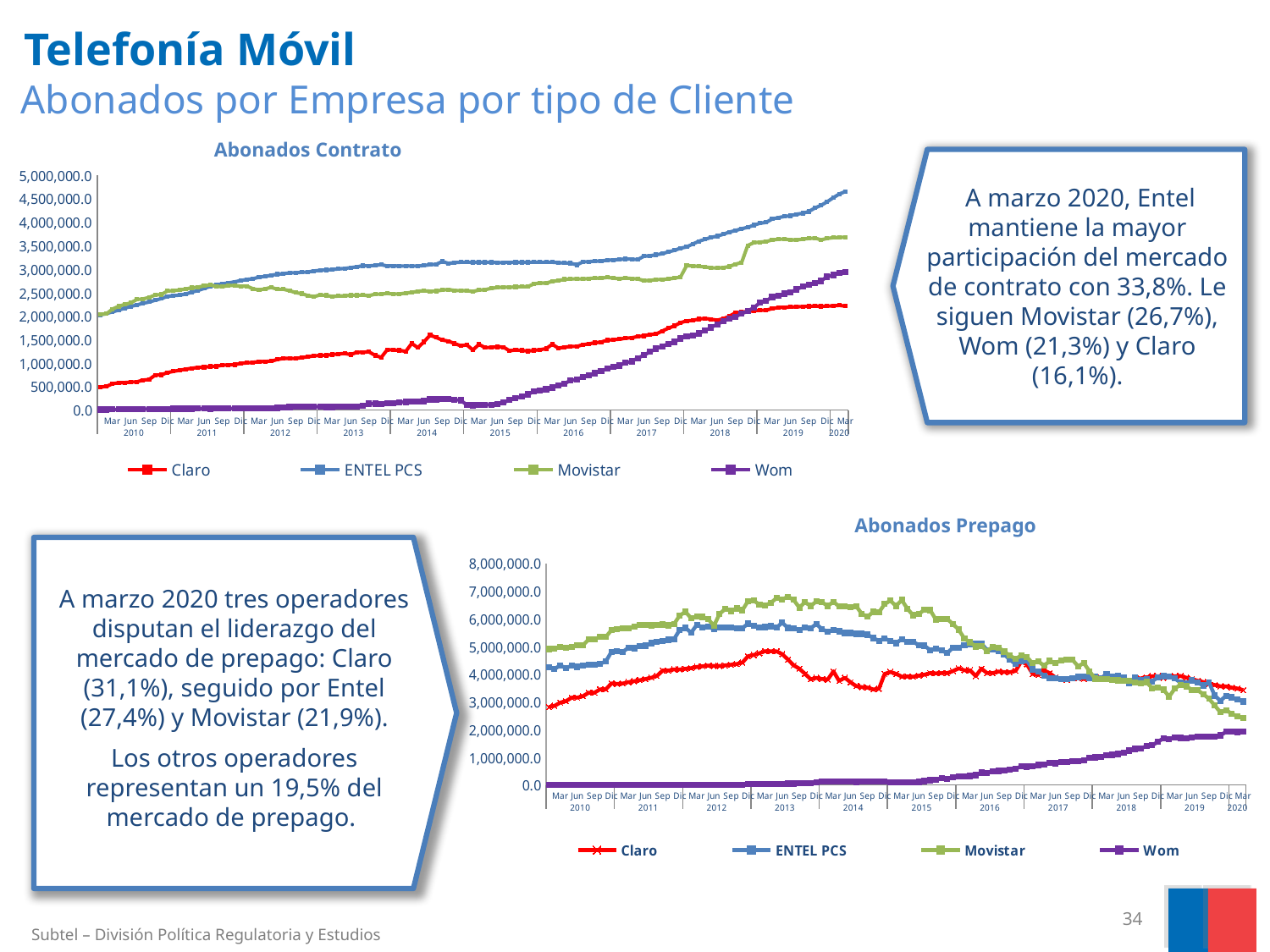
What is the title of the lower chart on the slide? Abonados Prepago In the 'Abonados Prepago' chart, which series has the highest value at Mar 2020? Claro In the 'Abonados Prepago' chart, does the Movistar series rise or fall from 2016 to 2020? fall What kind of chart is the 'Abonados Contrato' chart? line chart In the 'Abonados Contrato' chart, which series has the highest value at Mar 2020? ENTEL PCS In the 'Abonados Prepago' chart, is the value for Claro at Mar 2020 greater or less than 3,000,000? greater In the 'Abonados Contrato' chart, which series has the lowest value at Mar 2020? Claro In the 'Abonados Contrato' chart, does the Wom series rise or fall from 2015 to 2020? rise In the 'Abonados Contrato' chart, is the value for Wom at Mar 2010 greater or less than 500,000? less How many series does the legend of the 'Abonados Prepago' chart list? 4 In the 'Abonados Prepago' chart, which series has the lowest value at Mar 2020? Wom In the 'Abonados Contrato' chart, is the value for ENTEL PCS at Mar 2020 greater or less than 4,000,000? greater